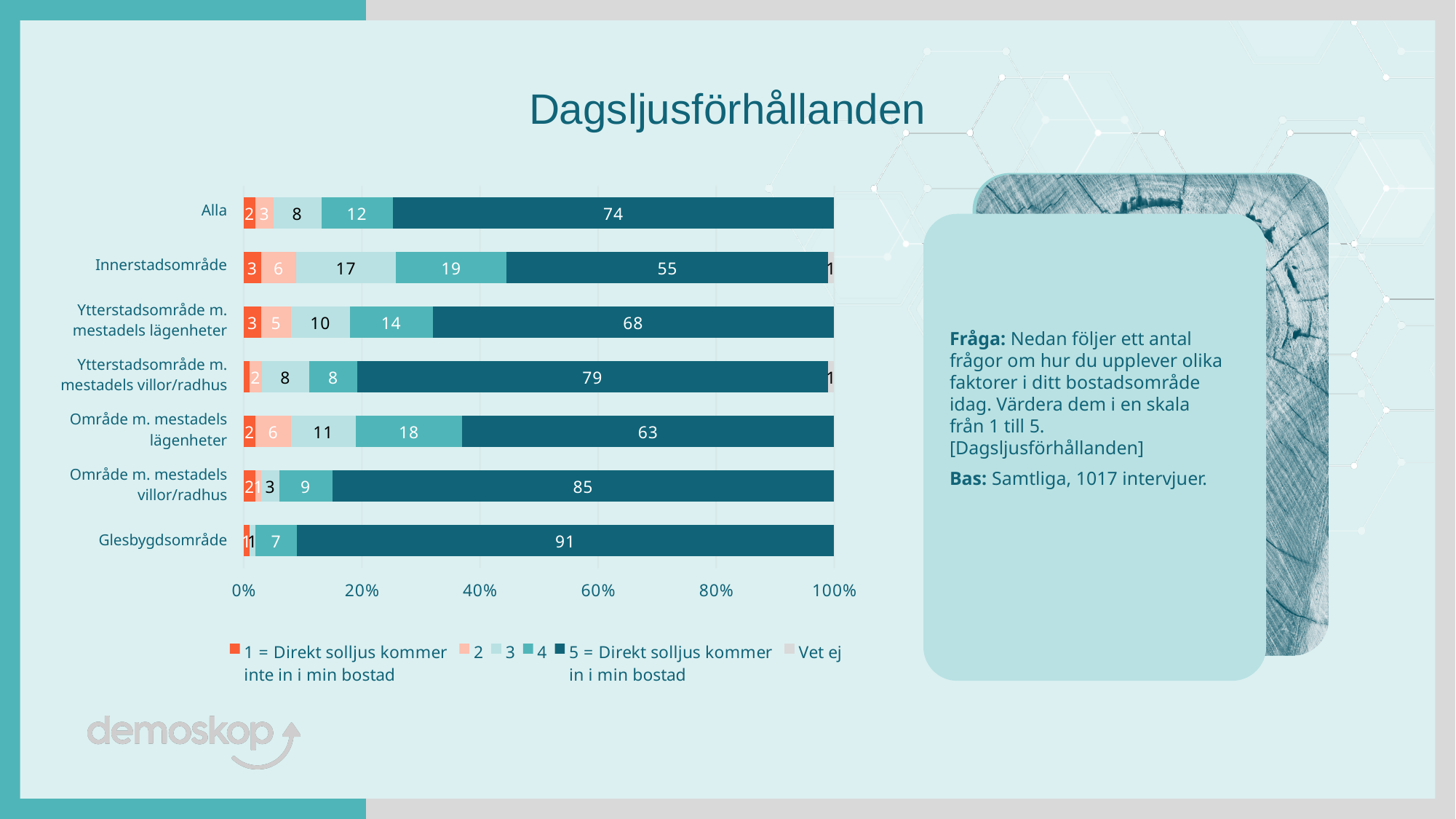
How many series does the legend list? 6 What is the value for "5 = Direkt solljus kommer in i min bostad" for Glesbygdsområde? 91 Which category has the highest value for "5 = Direkt solljus kommer in i min bostad"? Glesbygdsområde What is the value for "5 = Direkt solljus kommer in i min bostad" for Alla? 74 What is the value for series 4 for Innerstadsområde? 19 What is the title of the chart? Dagsljusförhållanden Which category has the lowest value for "5 = Direkt solljus kommer in i min bostad"? Innerstadsområde What is the value for series 3 for Ytterstadsområde m. mestadels lägenheter? 10 How many categories are shown on the y axis of the chart? 7 Which has a larger value for series 4: Område m. mestadels lägenheter or Område m. mestadels villor/radhus? Område m. mestadels lägenheter What kind of chart is shown on the slide? Stacked bar chart What is the difference between the "5 = Direkt solljus kommer in i min bostad" values for Glesbygdsområde and Innerstadsområde? 36